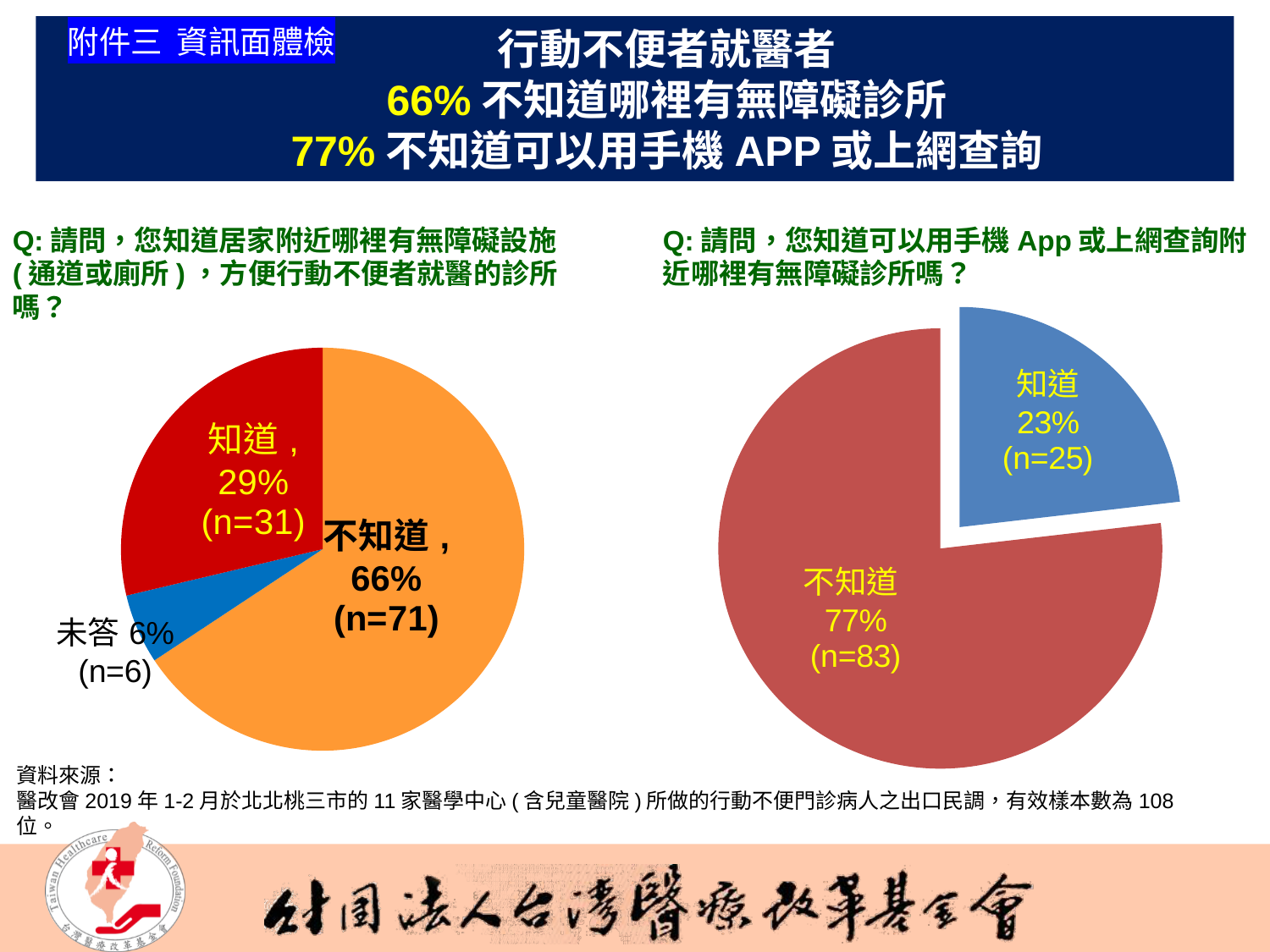
In the right pie chart, how many respondents (n) answered 不知道? n=83 In the right pie chart, what percentage of respondents answered 知道? 23% What type of chart is shown on the right side of the slide? Pie chart In the left pie chart, how many respondents (n) answered 知道? n=31 In the left pie chart, which category has the smallest share? 未答 In the right pie chart, which category has the larger share? 不知道 In the left pie chart, what percentage is shown for 未答? 6% In the left pie chart, what percentage of respondents answered 不知道? 66% In the right pie chart, what is the difference in percentage points between 不知道 and 知道? 54 How many slices does the left pie chart have? 3 In the left pie chart, which category has the largest share? 不知道 In the left pie chart, what is the difference in percentage points between 不知道 and 知道? 37